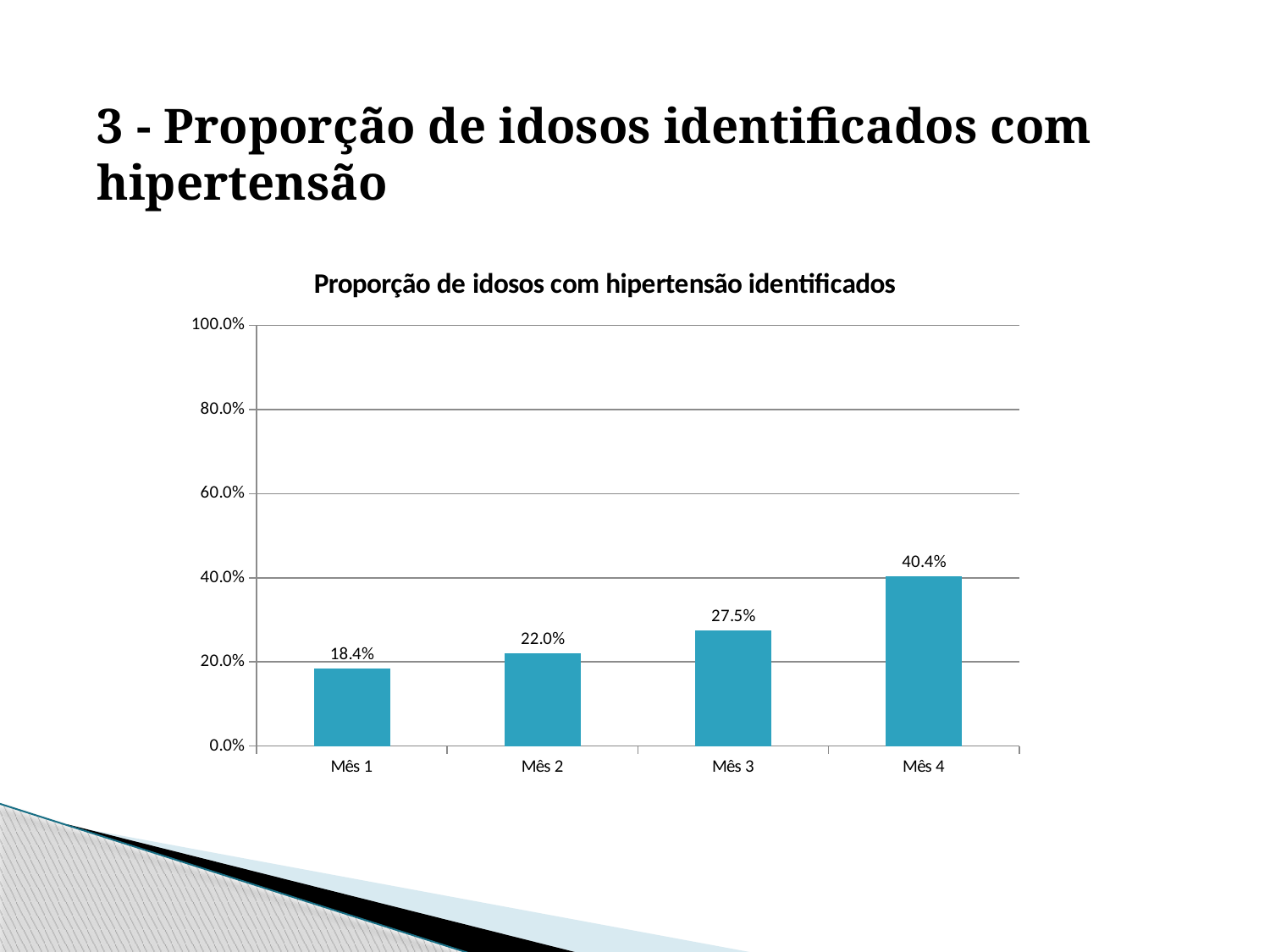
What is the difference between the values for Mês 4 and Mês 1? 22.0% Which month has the lowest proportion? Mês 1 Do the values rise or fall from Mês 1 to Mês 4? rise How many months are shown on the x axis? 4 What is the value for Mês 1? 18.4% Which month has the highest proportion? Mês 4 What kind of chart is shown? bar chart What is the difference between the values for Mês 3 and Mês 2? 5.5% What is the value for Mês 3? 27.5% Is the value for Mês 4 greater or less than 40.0%? greater What is the value for Mês 4? 40.4% Which is larger, the value for Mês 2 or the value for Mês 3? Mês 3